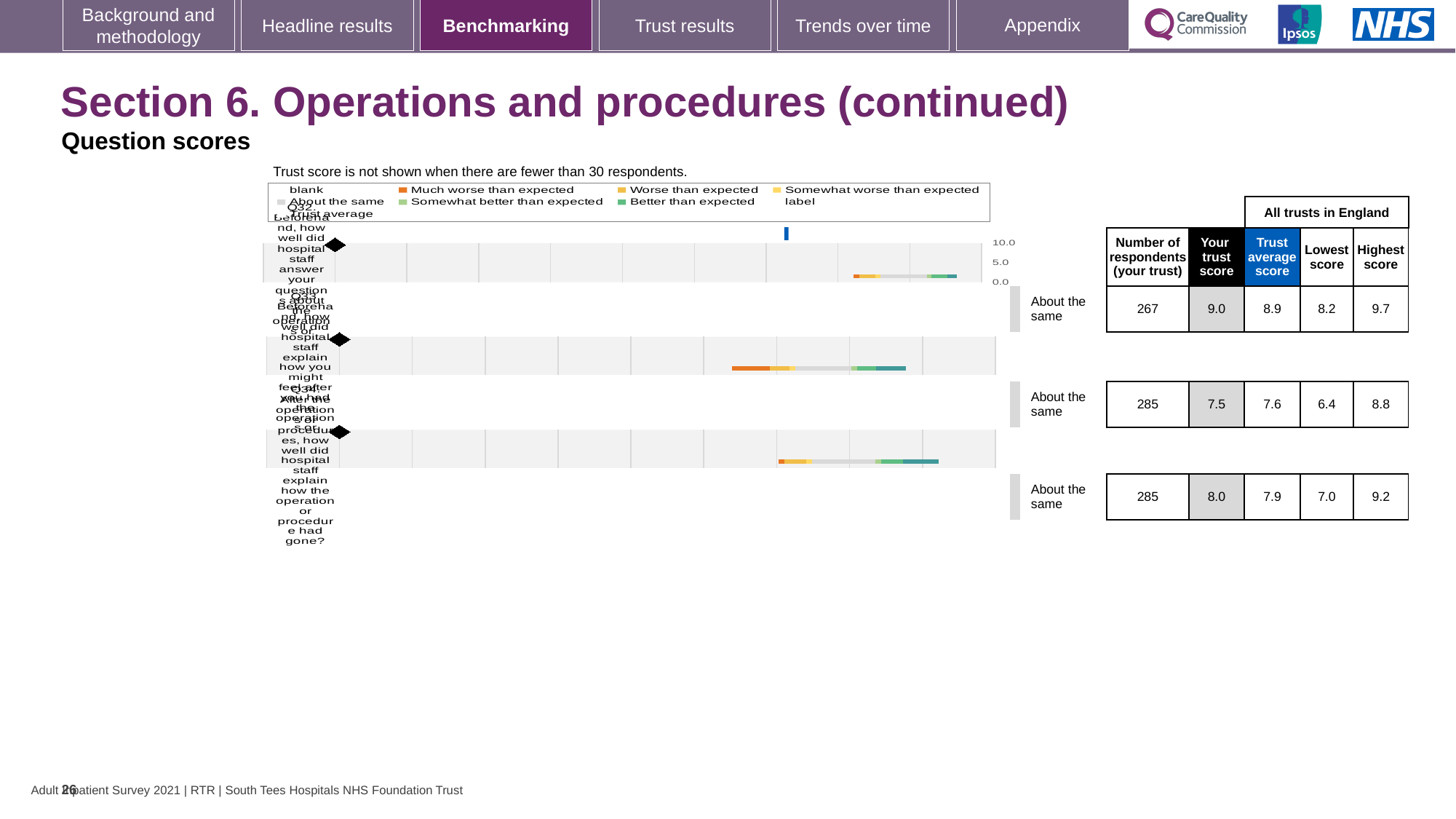
For the first (top) question row, how many respondents does the table show for your trust? 267 Which question row has the highest 'Your trust score' in the table? The first (top) row, 9.0 How many question score charts are shown on the slide? 3 What is the highest value shown on the score axis of the top chart? 10.0 For the second (middle) question row, how much higher is your trust score than the lowest score? 1.1 What kind of chart is used to show the question scores on this slide? Bar chart For the first (top) question row, what is your trust score? 9.0 For the third (bottom) question row, what is the difference between the highest score and the lowest score? 2.2 For the first (top) question row, which is larger: your trust score or the trust average score? Your trust score For the second (middle) question row, what is the trust average score? 7.6 What benchmark category is shown next to each of the three question charts? About the same For the third (bottom) question row, what is the highest score among all trusts in England? 9.2